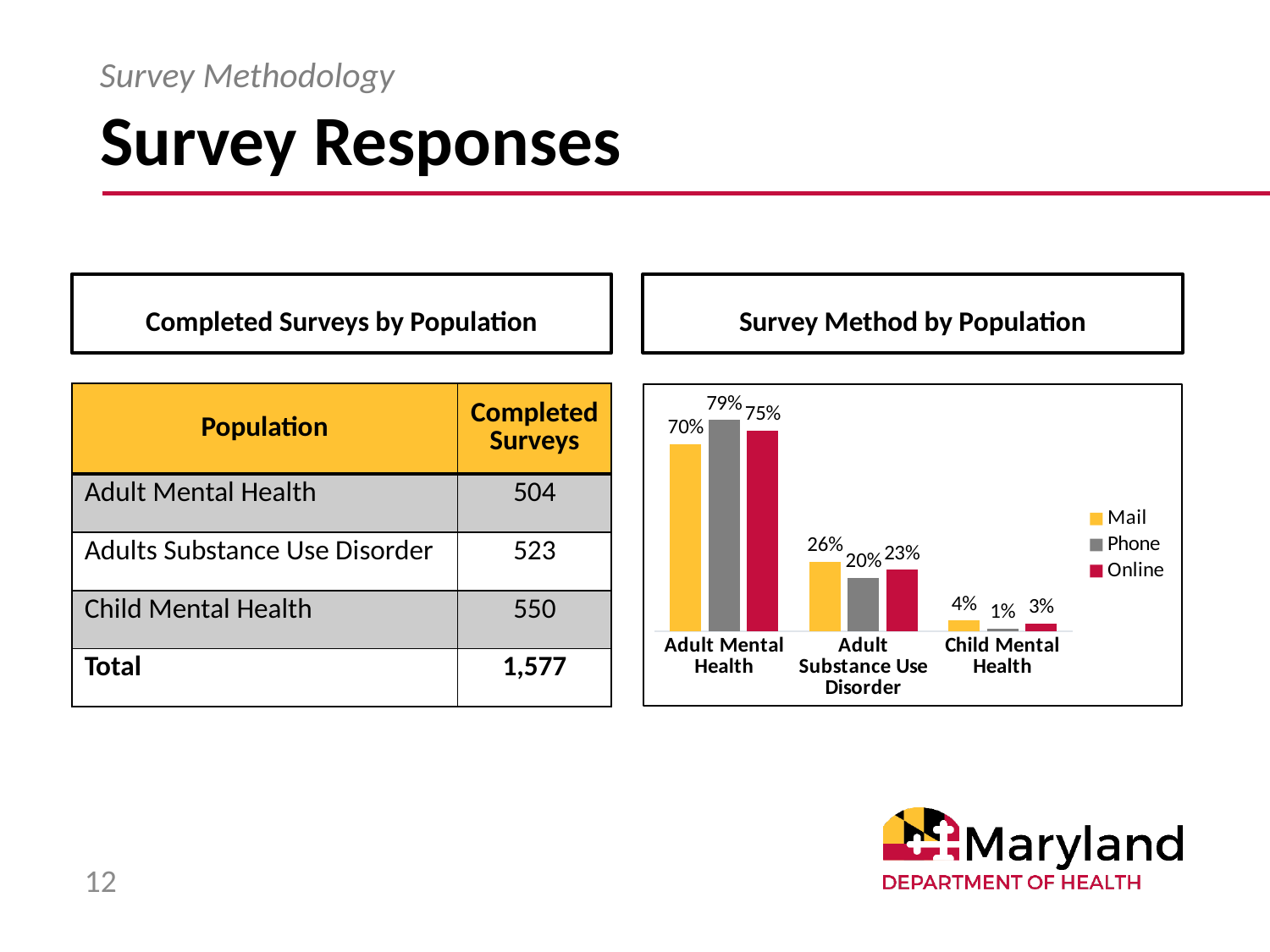
In the Survey Method by Population chart, do the Online values rise or fall from Adult Mental Health to Child Mental Health? Fall In the Survey Method by Population chart, which is larger for Adult Substance Use Disorder: the Mail value or the Online value? Mail In the Survey Method by Population chart, which population has the highest Phone value? Adult Mental Health In the Survey Method by Population chart, what is the difference between the Phone and Mail values for Adult Mental Health? 9% In the Survey Method by Population chart, what is the Online value for Child Mental Health? 3% In the Survey Method by Population chart, what is the Phone value for Adult Substance Use Disorder? 20% In the Survey Method by Population chart, how many series does the legend list? 3 What kind of chart is the Survey Method by Population chart? Bar chart In the Survey Method by Population chart, which series is shown in red? Online In the Survey Method by Population chart, what is the Mail value for Adult Mental Health? 70% In the Survey Method by Population chart, how many populations are shown on the x axis? 3 In the Survey Method by Population chart, which population has the lowest Mail value? Child Mental Health